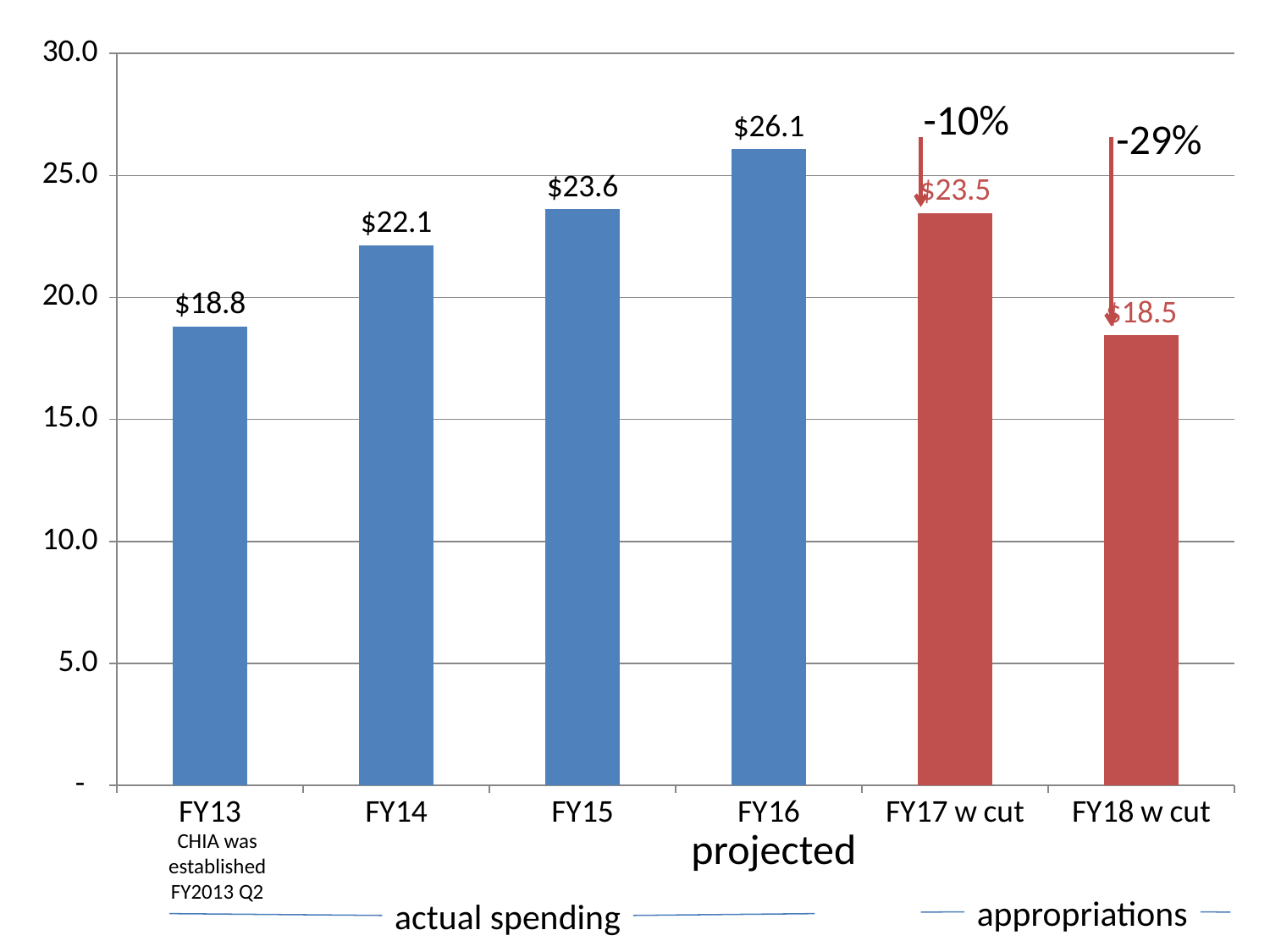
Which category has the highest value? FY16 Which category has the lowest value? FY18 w cut What percentage change is annotated above the FY18 w cut bar? -29% Is the value for FY14 greater or less than 20.0? greater Which is larger, the value for FY15 or the value for FY17 w cut? FY15 What is the value for FY18 w cut? $18.5 How many categories are shown on the x axis? 6 Do the values rise or fall from FY13 to FY16? rise What is the difference between the FY16 value and the FY17 w cut value? $2.6 What kind of chart is this? bar chart What is the value for FY16? $26.1 What is the value for FY13? $18.8